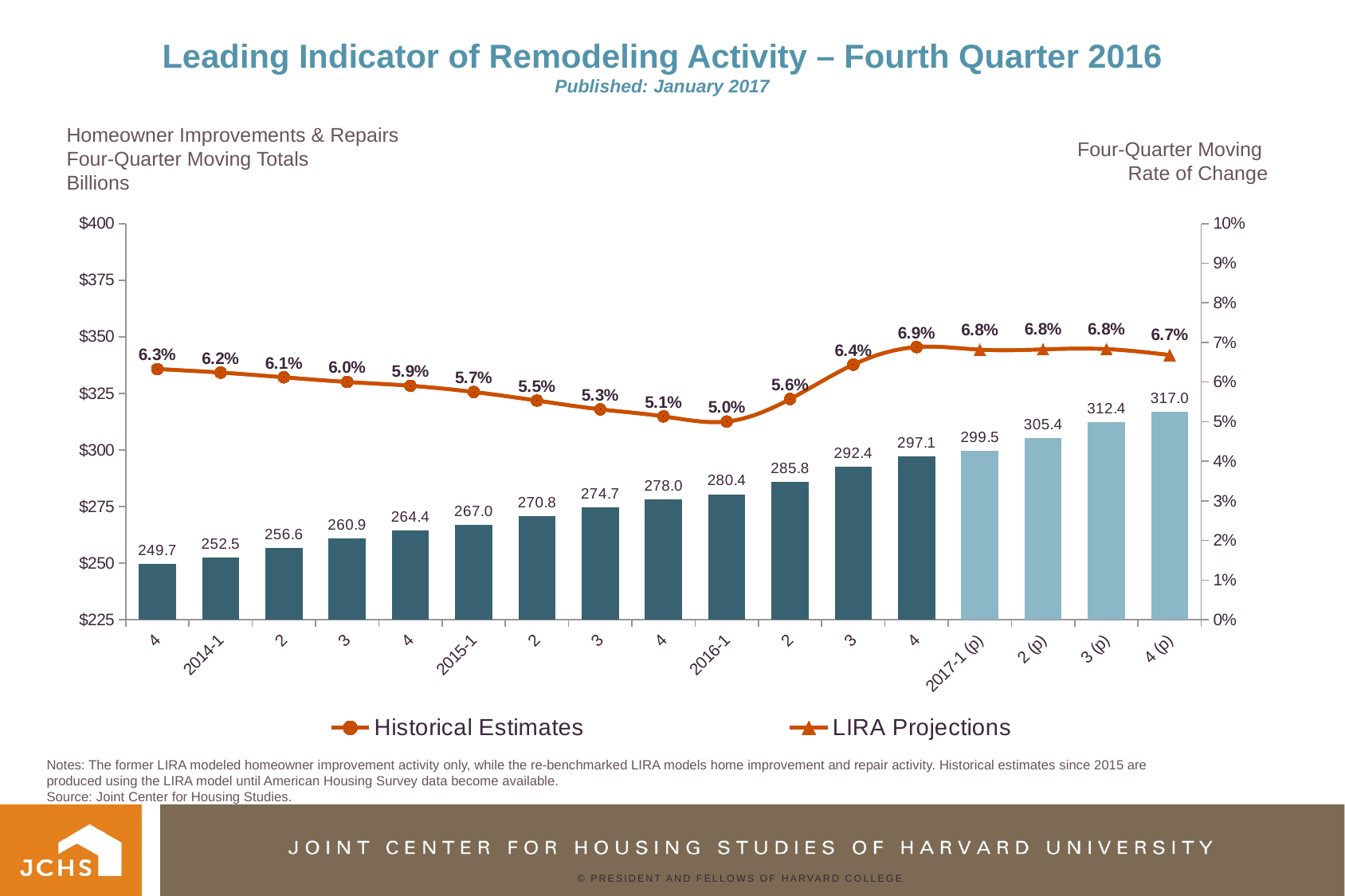
How many series does the legend list? 2 Do the four-quarter moving total bars rise or fall from left to right across the chart? rise Which quarter has the highest four-quarter moving total bar? 4 (p) of 2017, at 317.0 What is the four-quarter moving total for 2016-1? 280.4 What is the four-quarter moving rate of change projected for 2017-1 (p)? 6.8% Is the four-quarter moving total for 2016-3 greater or less than $300? less Which is larger, the rate of change for 2014-1 or for 2016-1? 2014-1 (6.2%) What is the four-quarter moving total for 2015-1? 267.0 What kind of chart is shown on the slide? A combination bar and line chart What is the difference between the four-quarter moving totals for 4 (p) of 2017 (317.0) and the first bar (249.7)? 67.3 Which quarter has the lowest four-quarter moving rate of change on the line? 2016-1, at 5.0% How many bars are plotted on the chart? 17